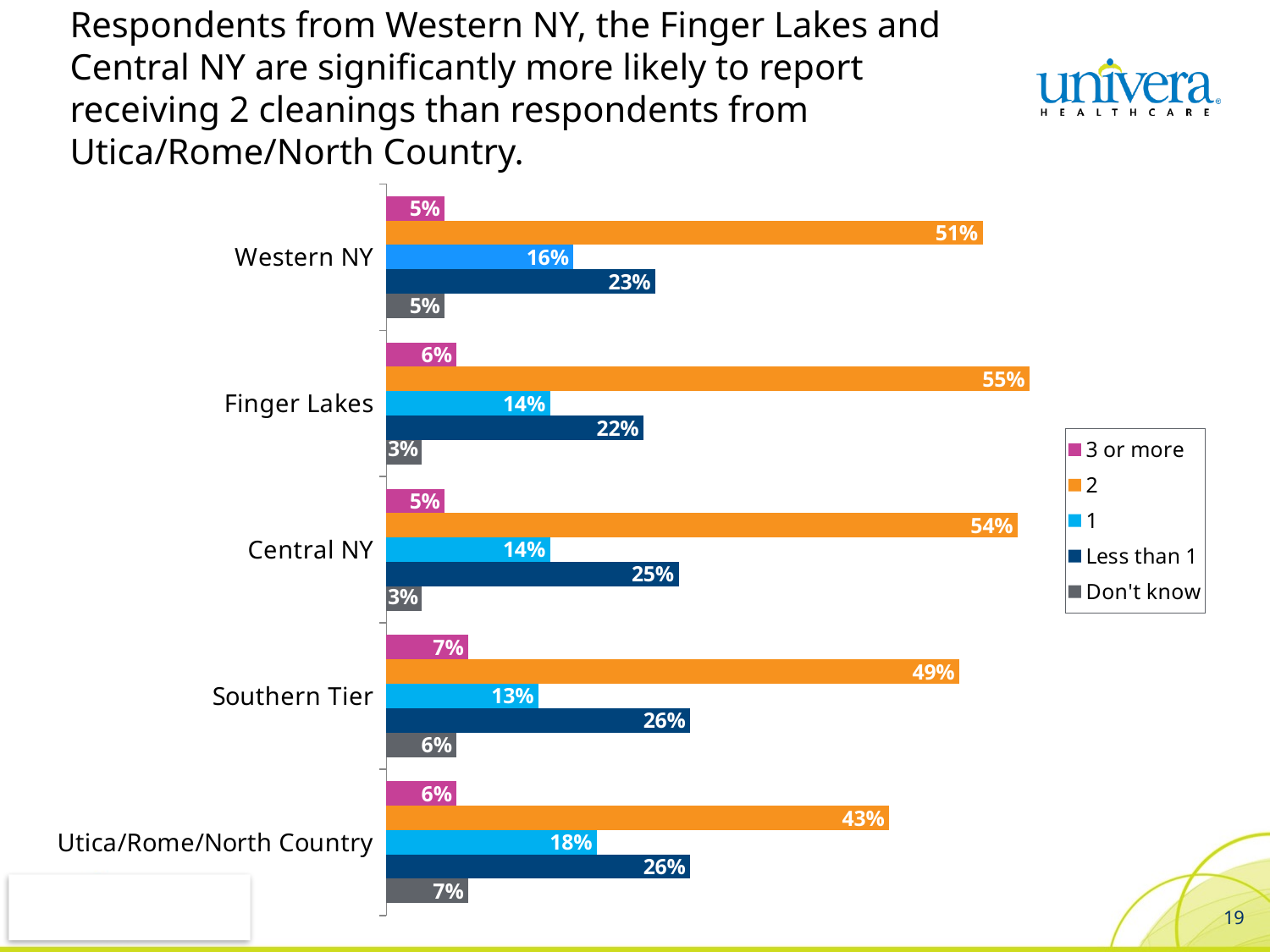
What is the '3 or more' value for Southern Tier? 7% How many series does the legend list? 5 What percentage of Utica/Rome/North Country respondents reported receiving 1 cleaning? 18% Which region has the highest percentage of respondents reporting 2 cleanings? Finger Lakes What percentage of Southern Tier respondents answered 'Don't know'? 6% What is the difference between the percentage of Central NY respondents and Utica/Rome/North Country respondents reporting 2 cleanings? 11% Which region has the lowest percentage of respondents reporting 2 cleanings? Utica/Rome/North Country What percentage of Finger Lakes respondents reported receiving 2 cleanings? 55% Which is larger: the 'Less than 1' value for Western NY or for Central NY? Central NY What kind of chart is shown on the slide? Bar chart Which legend entry is shown in orange? 2 How many regions are shown on the chart? 5